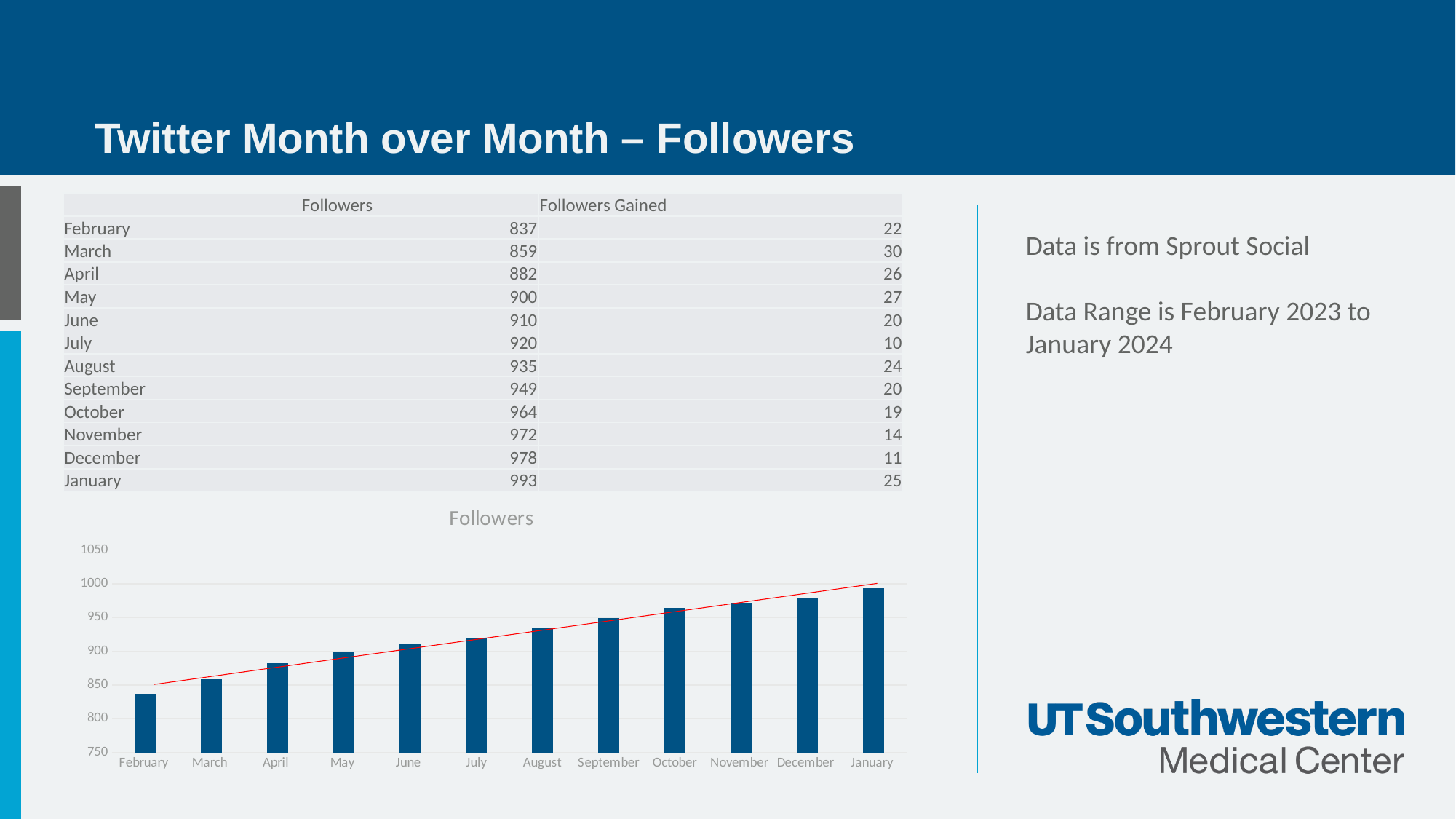
Which is larger, the followers value for May or the followers value for October? October Is the value for July greater or less than 900? greater What is the title of the chart? Followers Which month has the lowest number of followers in the chart? February Is the value for January greater or less than 950? greater Is the value for February greater or less than 850? less Do the follower values rise or fall from February to January along the x axis? rise According to the table on the slide, how many followers were there in September? 949 How many months are plotted on the x axis of the Followers chart? 12 What type of chart is shown on the slide? bar chart Which month has the highest number of followers in the chart? January Using the table values, what is the difference in followers between January and February? 156